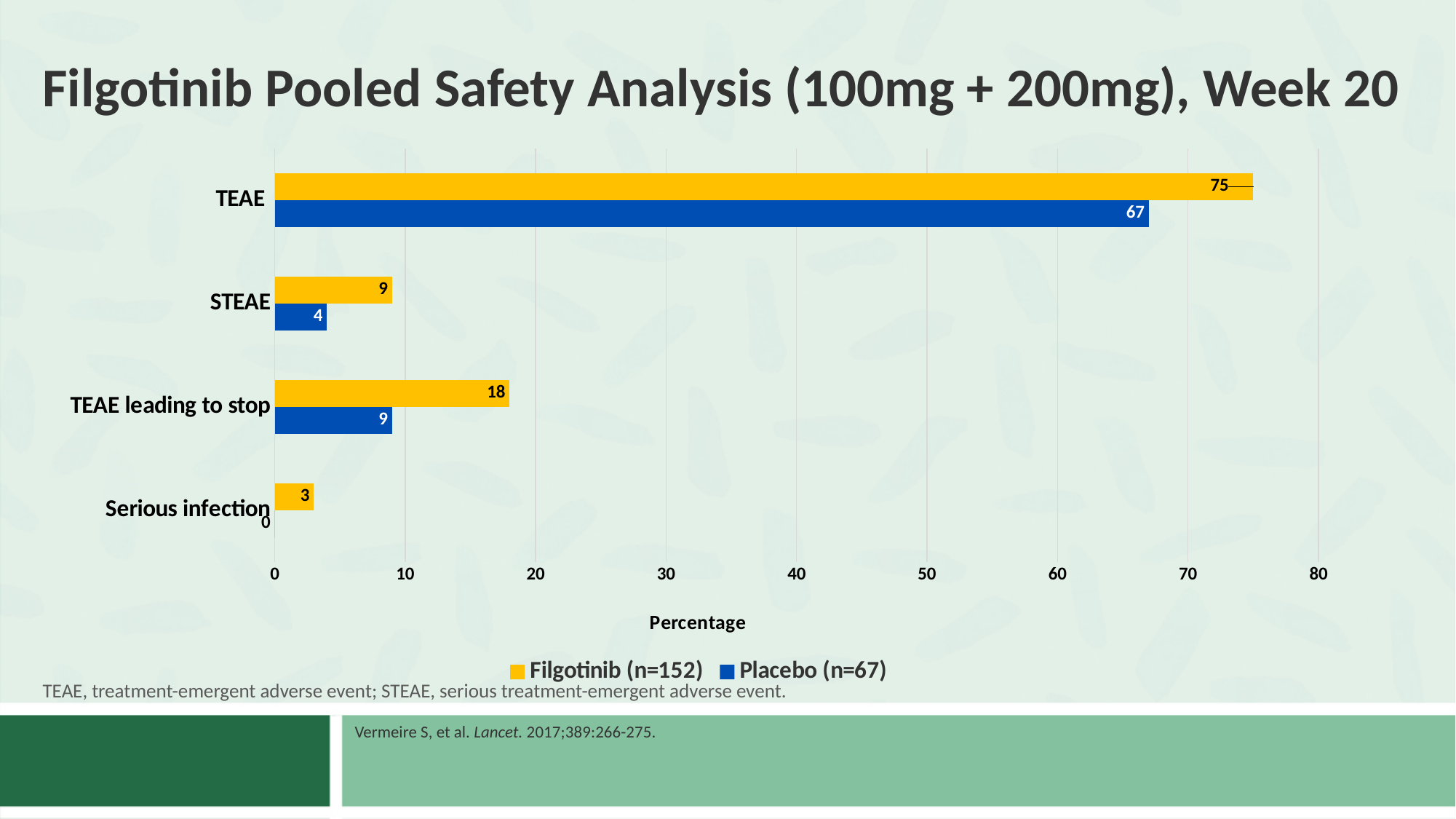
What is the Placebo (n=67) value for Serious infection? 0 What is the Filgotinib (n=152) value for TEAE? 75 What is the difference between the Filgotinib (n=152) and Placebo (n=67) values for STEAE? 5 What kind of chart is shown on the slide? Bar chart Which category has the lowest Placebo (n=67) value? Serious infection What is the Placebo (n=67) value for TEAE leading to stop? 9 Which category has the highest Filgotinib (n=152) value? TEAE What is the label of the horizontal axis? Percentage How many categories are shown on the chart? 4 What is the difference between the Filgotinib (n=152) and Placebo (n=67) values for TEAE? 8 Which is larger for TEAE leading to stop: Filgotinib (n=152) or Placebo (n=67)? Filgotinib (n=152) How many series does the legend list? 2